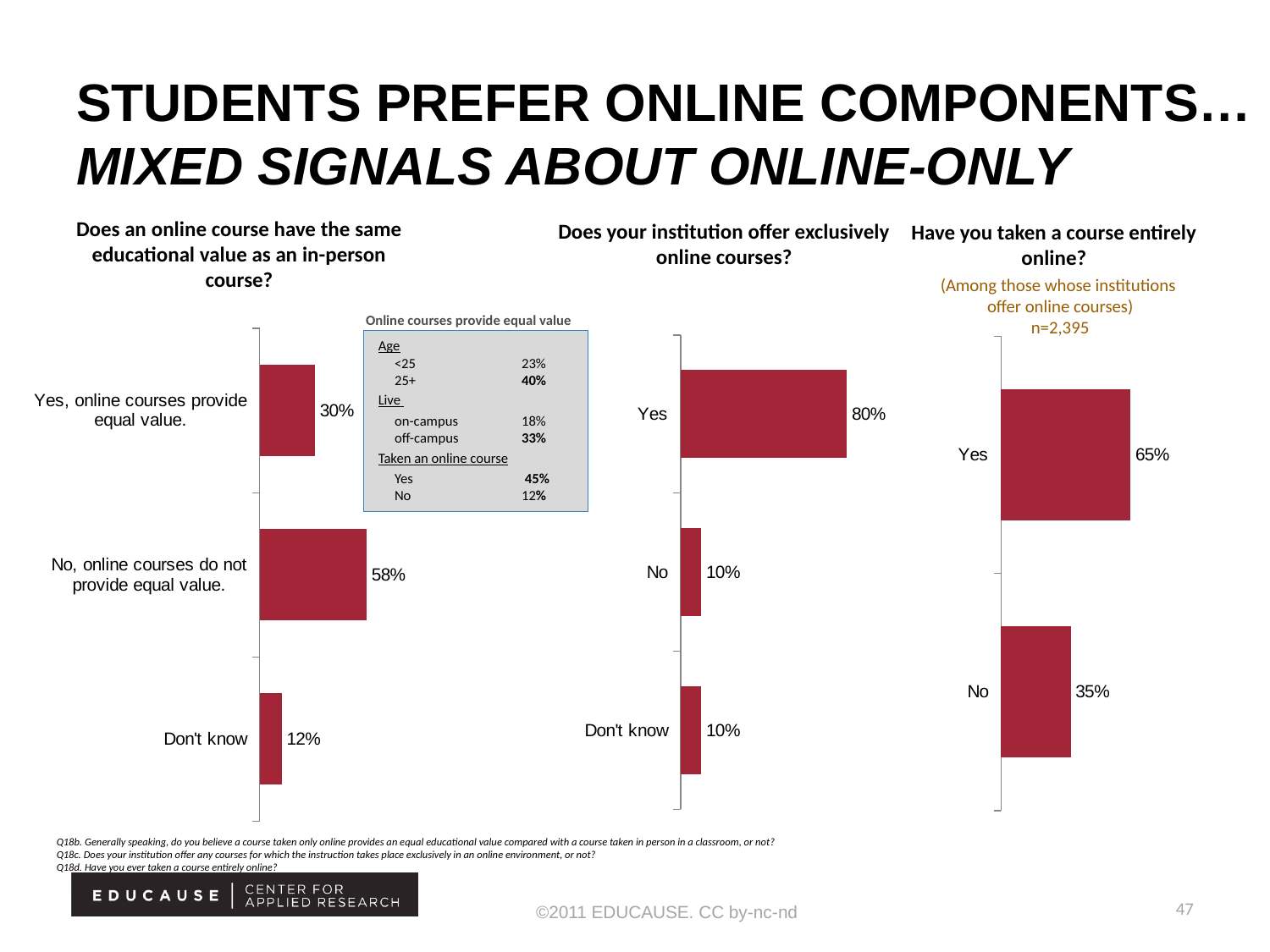
In the chart 'Does your institution offer exclusively online courses?', how many response categories are shown? 3 In the chart 'Does your institution offer exclusively online courses?', what is the difference between 'Yes' and 'No'? 70% In the chart 'Does an online course have the same educational value as an in-person course?', what percentage answered 'Don't know'? 12% What is the sample size (n) shown for the chart 'Have you taken a course entirely online?'? n=2,395 In the chart 'Does an online course have the same educational value as an in-person course?', what percentage answered 'Yes, online courses provide equal value.'? 30% In the chart 'Does your institution offer exclusively online courses?', what percentage answered 'Yes'? 80% What type of chart is used for 'Have you taken a course entirely online?'? Bar chart In the chart 'Have you taken a course entirely online?', what is the difference between 'Yes' and 'No'? 30% In the chart 'Have you taken a course entirely online?', which response is larger, 'Yes' or 'No'? Yes In the chart 'Does an online course have the same educational value as an in-person course?', what is the difference between the 'No' and 'Yes' responses? 28% In the chart 'Have you taken a course entirely online?', what percentage answered 'No'? 35% In the chart 'Does an online course have the same educational value as an in-person course?', which response has the highest value? No, online courses do not provide equal value.